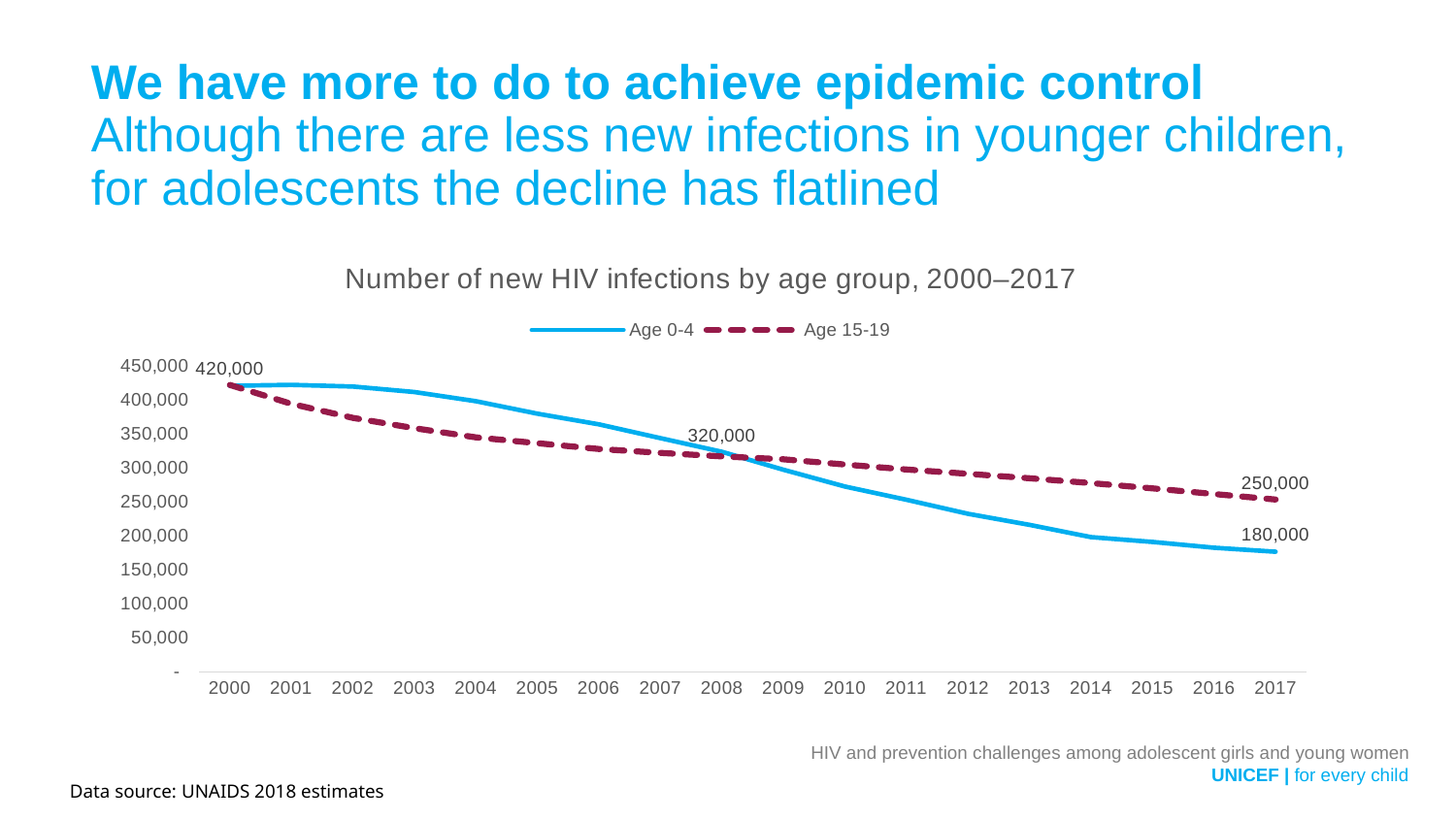
What is the number of new HIV infections for Age 0-4 in 2017? 180,000 Is the value for Age 0-4 in 2010 greater or less than 300,000? less What is the number of new HIV infections for Age 15-19 in 2017? 250,000 Does the Age 0-4 line rise or fall from 2000 to 2017? Fall What value is labelled at the start of the lines in 2000? 420,000 What is the difference between the Age 15-19 and Age 0-4 values in 2017? 70,000 Which series is drawn with a dashed line? Age 15-19 What kind of chart is shown on the slide? Line chart How many series does the legend list? 2 In 2017, which age group has the higher number of new HIV infections? Age 15-19 How many years are shown on the x axis? 18 What is the title of the chart? Number of new HIV infections by age group, 2000–2017